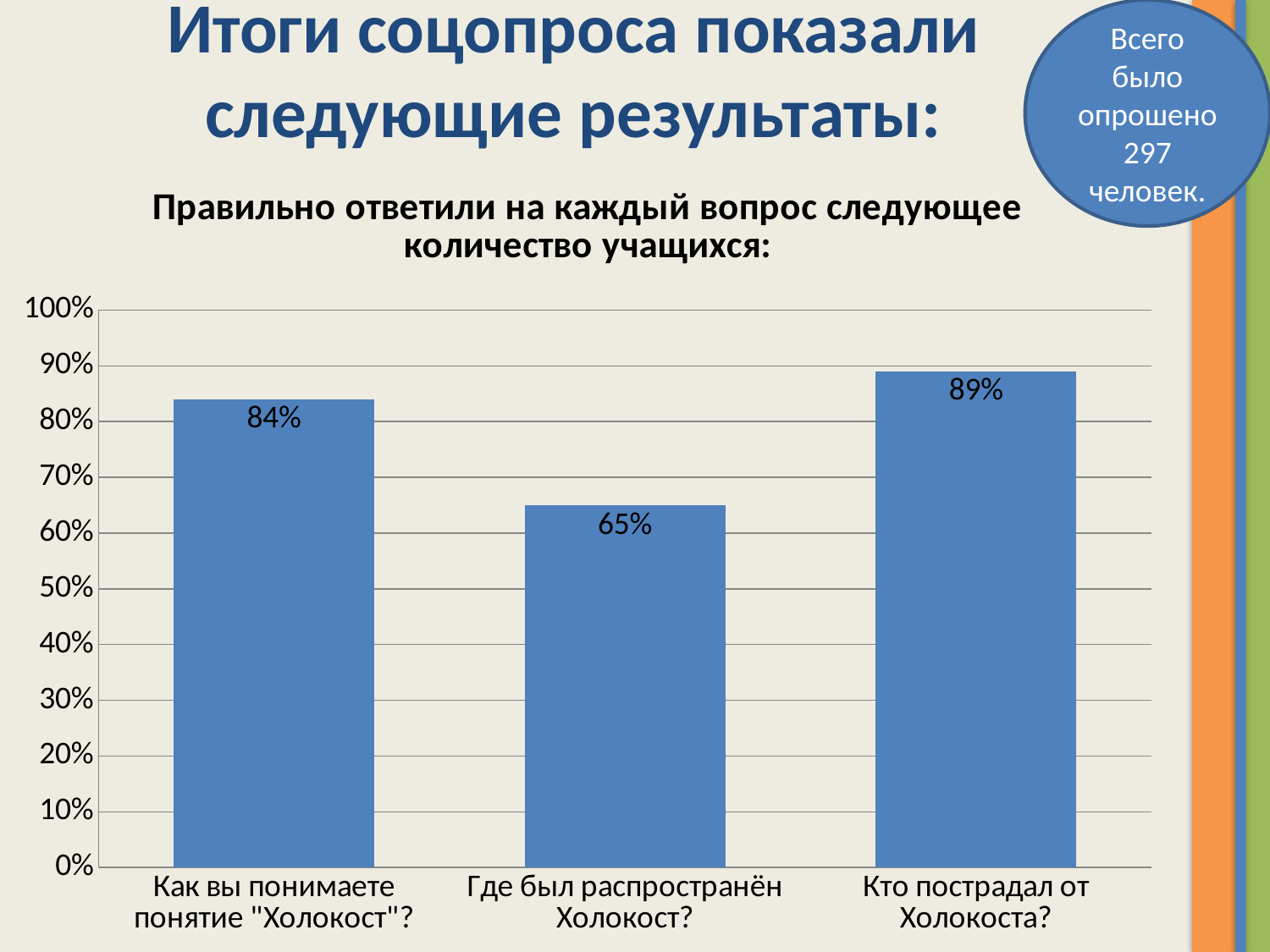
What percentage of students answered the question "Кто пострадал от Холокоста?" correctly? 89% Which question has the highest share of correct answers? Кто пострадал от Холокоста? How many questions (categories) are shown on the chart? 3 Which has a higher correct-answer rate: "Как вы понимаете понятие "Холокост"?" or "Где был распространён Холокост?"? Как вы понимаете понятие "Холокост"? Which question has the lowest share of correct answers? Где был распространён Холокост? What is the difference between the correct-answer rates for "Кто пострадал от Холокоста?" and "Как вы понимаете понятие "Холокост"?"? 5% What is the difference between the correct-answer rates for "Кто пострадал от Холокоста?" and "Где был распространён Холокост?"? 24% What kind of chart is shown on the slide? bar chart What percentage of students answered the question "Где был распространён Холокост?" correctly? 65% What percentage of students answered the question "Как вы понимаете понятие "Холокост"?" correctly? 84% Is the value for "Где был распространён Холокост?" greater or less than 70%? less According to the slide, how many people were surveyed in total? 297